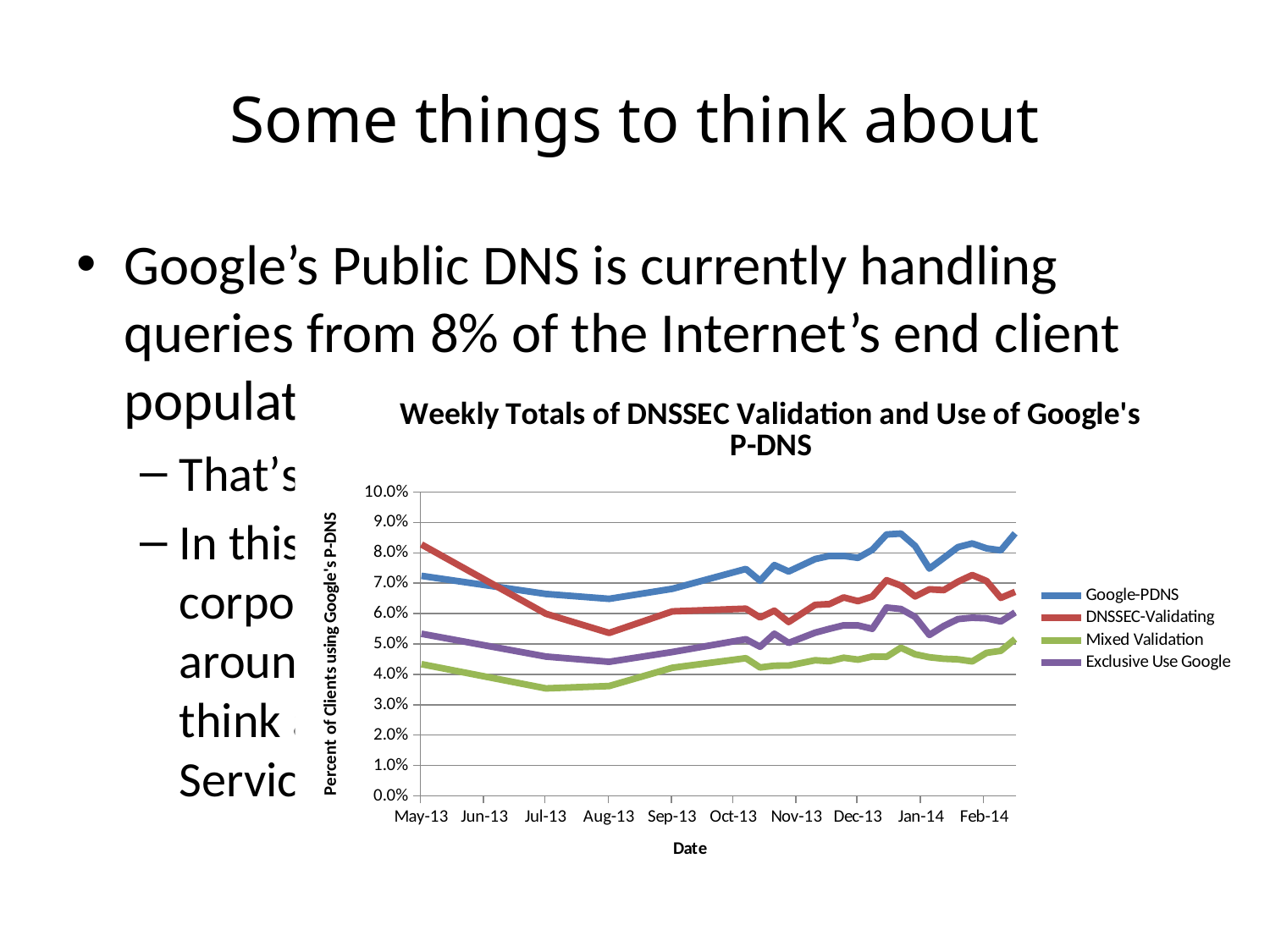
What is the title of the chart? Weekly Totals of DNSSEC Validation and Use of Google's P-DNS How many month labels are shown on the x axis? 10 How many series does the chart's legend list? 4 Is the value for Mixed Validation at Jul-13 greater or less than 4.0%? less Is the value for Exclusive Use Google at Aug-13 greater or less than 5.0%? less Which series has the lowest values throughout the chart? Mixed Validation Is the value for Google-PDNS at May-13 greater or less than 6.0%? greater Does the DNSSEC-Validating series rise or fall between May-13 and Aug-13? Fall What is the label on the chart's vertical axis? Percent of Clients using Google's P-DNS At Feb-14, which is larger: the Google-PDNS value or the Mixed Validation value? Google-PDNS What kind of chart is shown on the slide? Line chart